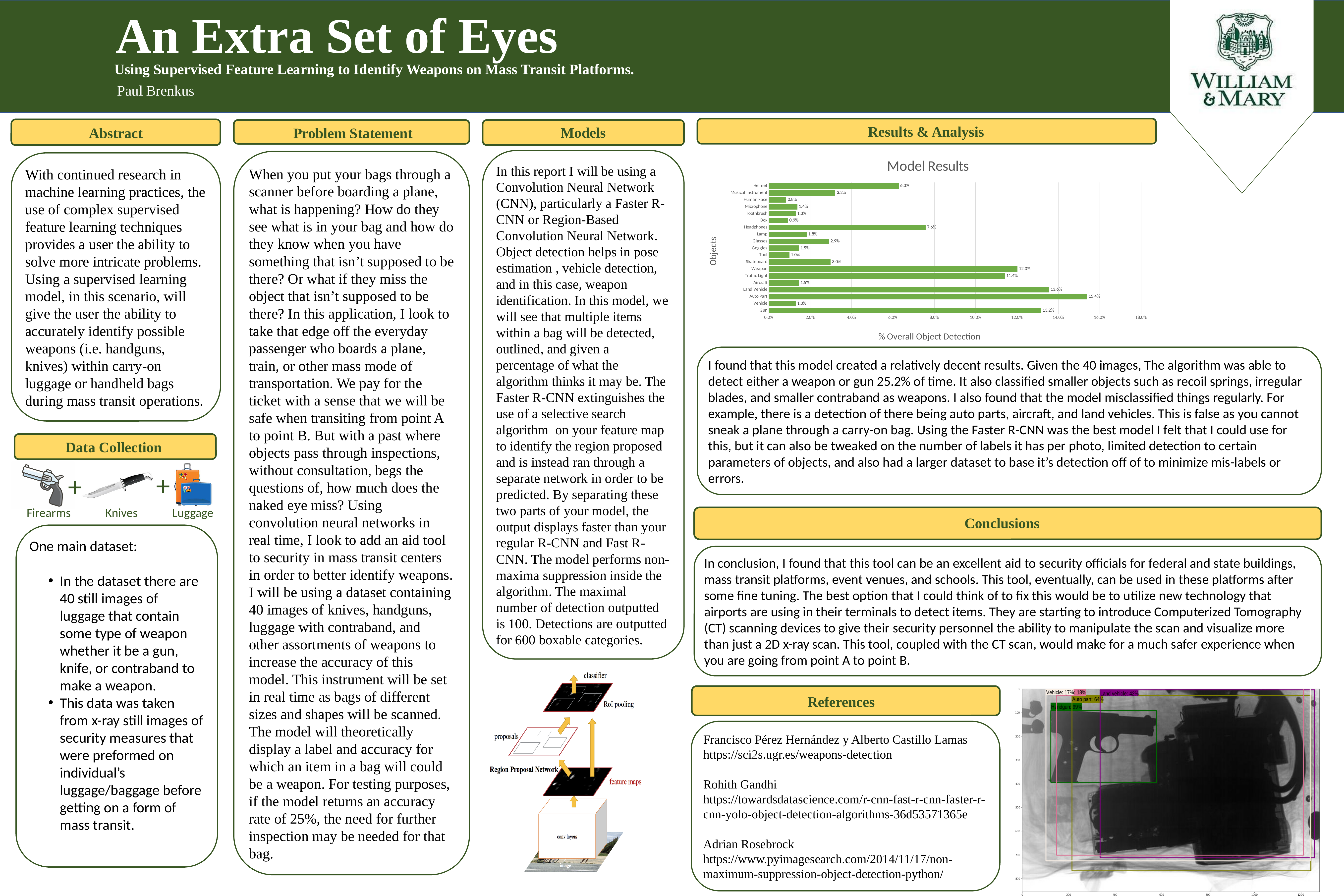
In the "Model Results" chart, is the value for Auto Part greater or less than 14.0%? greater In the "Model Results" chart, what is the value for Headphones? 7.6% What type of chart is the "Model Results" chart? bar chart In the "Model Results" chart, what is the difference between the values for Gun and Weapon? 1.2% In the "Model Results" chart, what is the value for Gun? 13.2% In the "Model Results" chart, which is larger, the value for Headphones or the value for Helmet? Headphones In the "Model Results" chart, which object has the highest % Overall Object Detection? Auto Part In the "Model Results" chart, what is the % Overall Object Detection for Weapon? 12.0% In the "Model Results" chart, what is the difference between the values for Auto Part and Land Vehicle? 1.8% In the "Model Results" chart, which object has the lowest % Overall Object Detection? Human Face How many object categories are shown in the "Model Results" chart? 19 What is the x-axis label of the "Model Results" chart? % Overall Object Detection